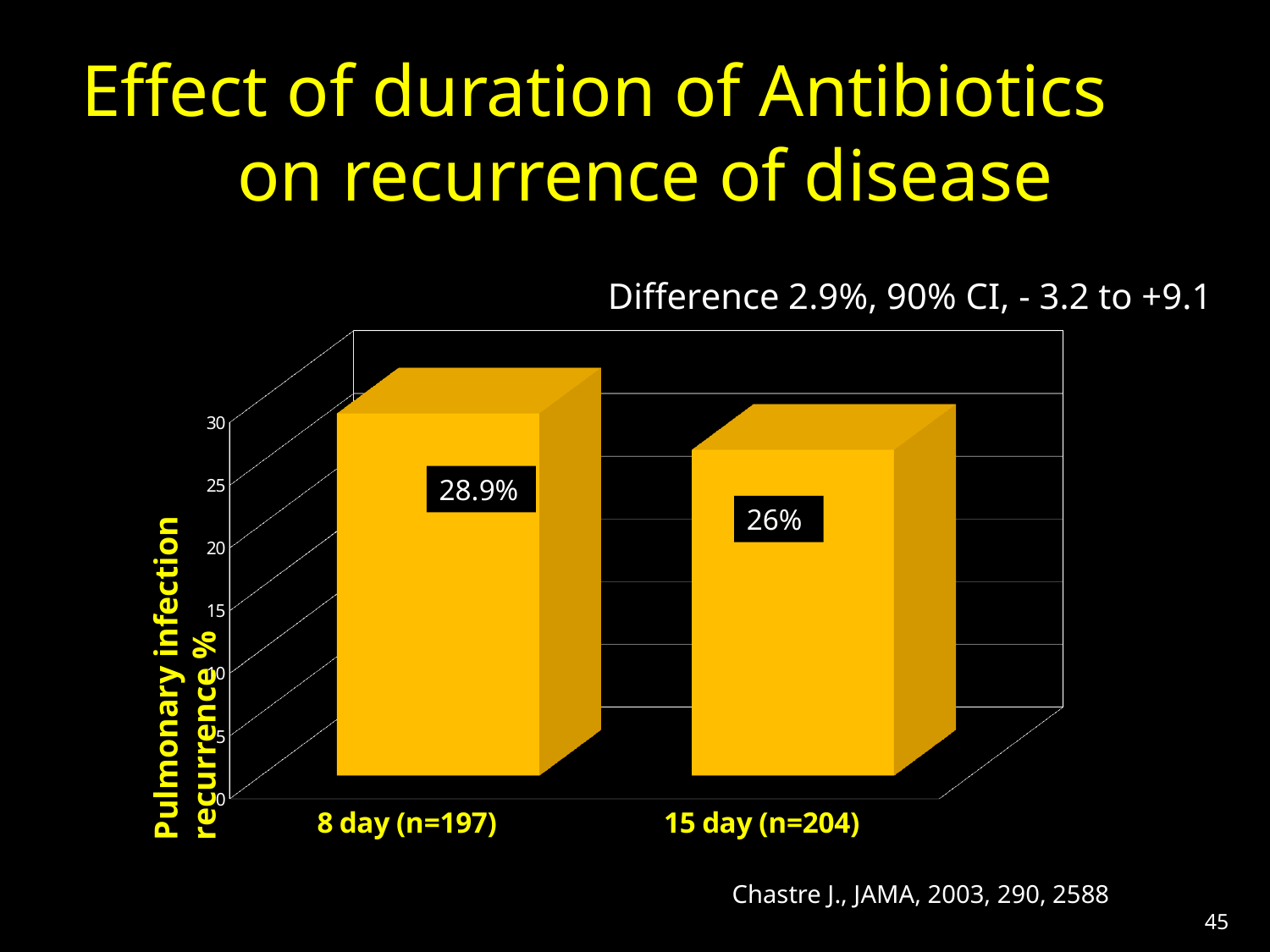
Is the recurrence % for the 8 day group larger or smaller than for the 15 day group? larger Which group has the higher pulmonary infection recurrence %? 8 day (n=197) What is the pulmonary infection recurrence % for the 8 day (n=197) group? 28.9% Is the value for the 15 day (n=204) group greater or less than 20? greater What 90% confidence interval is stated for the difference above the chart? - 3.2 to +9.1 What is the pulmonary infection recurrence % for the 15 day (n=204) group? 26% What is the label of the vertical axis of the chart? Pulmonary infection recurrence % Is the value for the 8 day (n=197) group greater or less than 30? less Which group has the lower pulmonary infection recurrence %? 15 day (n=204) What is the difference in recurrence % between the 8 day and 15 day groups? 2.9% What kind of chart is shown on the slide? bar chart How many categories are shown on the x axis of the chart? 2